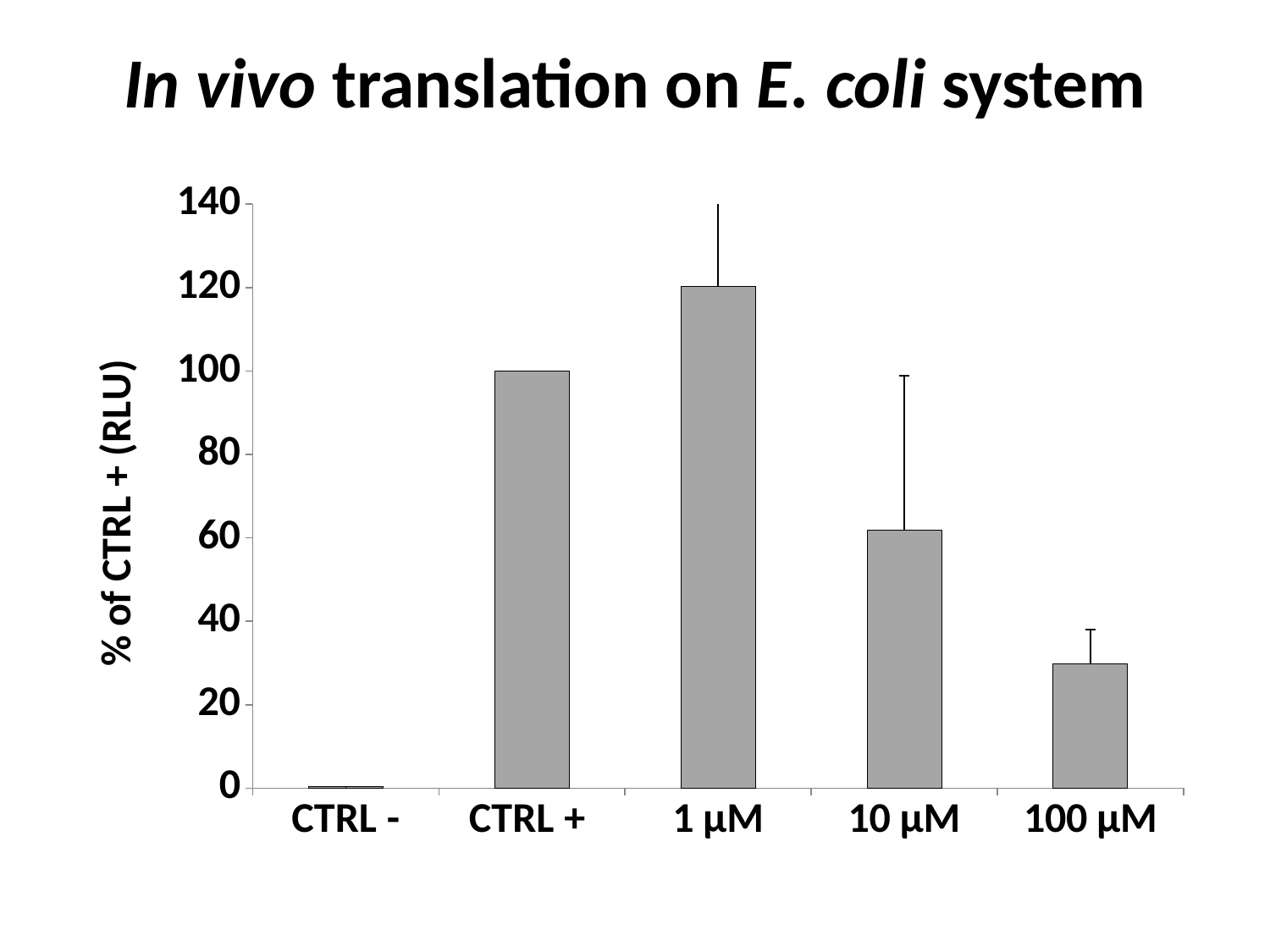
What is the title shown above the chart? In vivo translation on E. coli system How many categories are plotted on the x axis? 5 Which category has the lowest bar? CTRL - What kind of chart is shown on the slide? bar chart What is the value for CTRL +? 100 Do the values rise or fall from 1 µM to 100 µM? fall Is the value for 100 µM greater or less than 40? less What is the label of the y axis? % of CTRL + (RLU) Is the value for 1 µM greater or less than 100? greater Which is larger, the value for 10 µM or the value for 100 µM? 10 µM Which category has the highest bar? 1 µM Is the value for 10 µM greater or less than 80? less